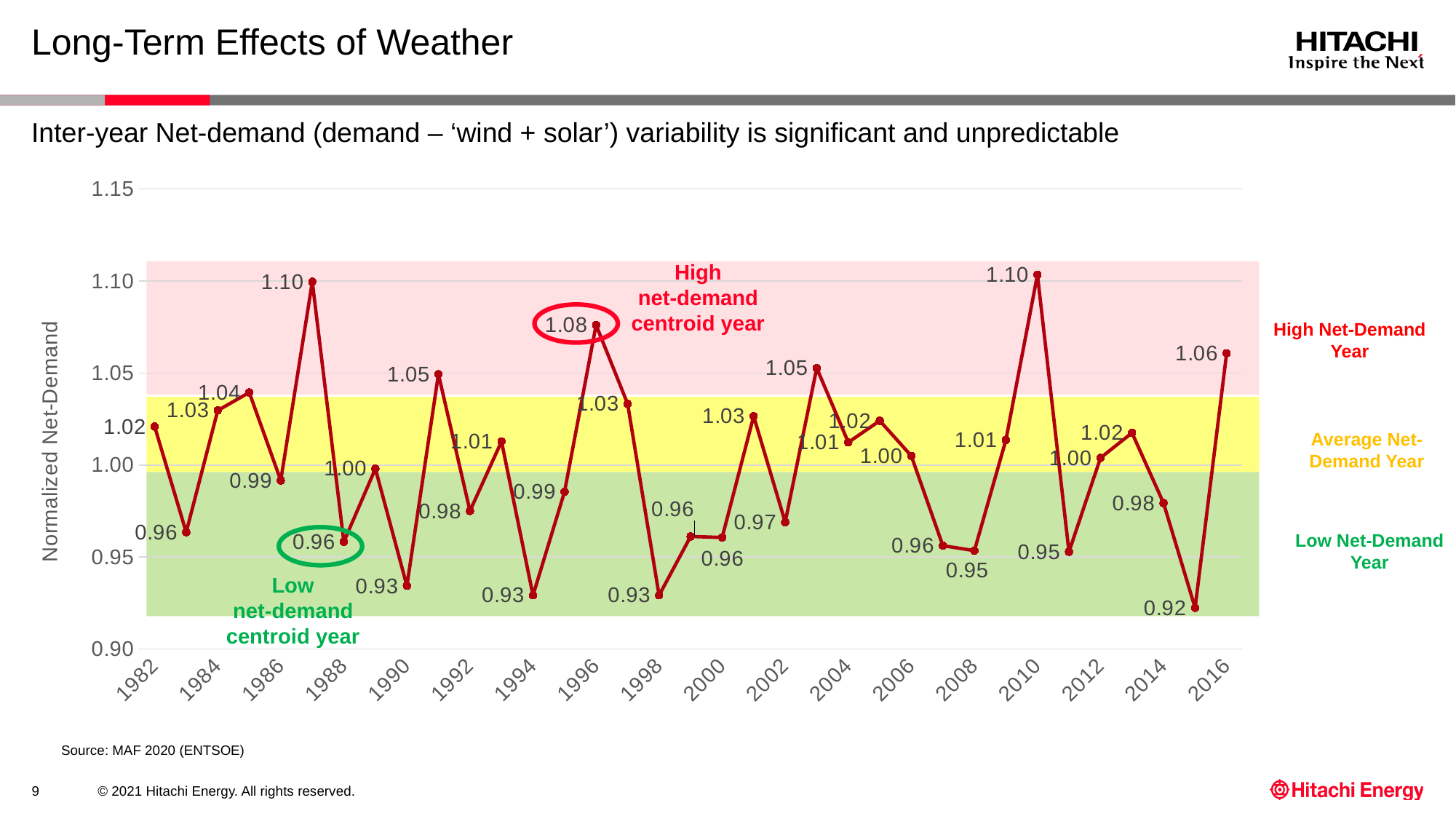
What is the normalized net-demand value for 2000? 0.96 Is the normalized net-demand value for 1998 greater or less than 0.95? less What kind of chart is shown on the slide? line chart What is the value of the point circled in red as the high net-demand centroid year? 1.08 Which year has the higher normalized net-demand, 1990 or 1992? 1992 What is the difference between the normalized net-demand values for 2010 and 2012? 0.10 What is the difference between the normalized net-demand values for 2016 and 2014? 0.08 What is the lowest normalized net-demand value plotted on the chart? 0.92 What is the normalized net-demand value for 2010? 1.10 What is the normalized net-demand value for 2016? 1.06 What is the normalized net-demand value for 1982? 1.02 What is the title of the vertical axis of the chart? Normalized Net-Demand